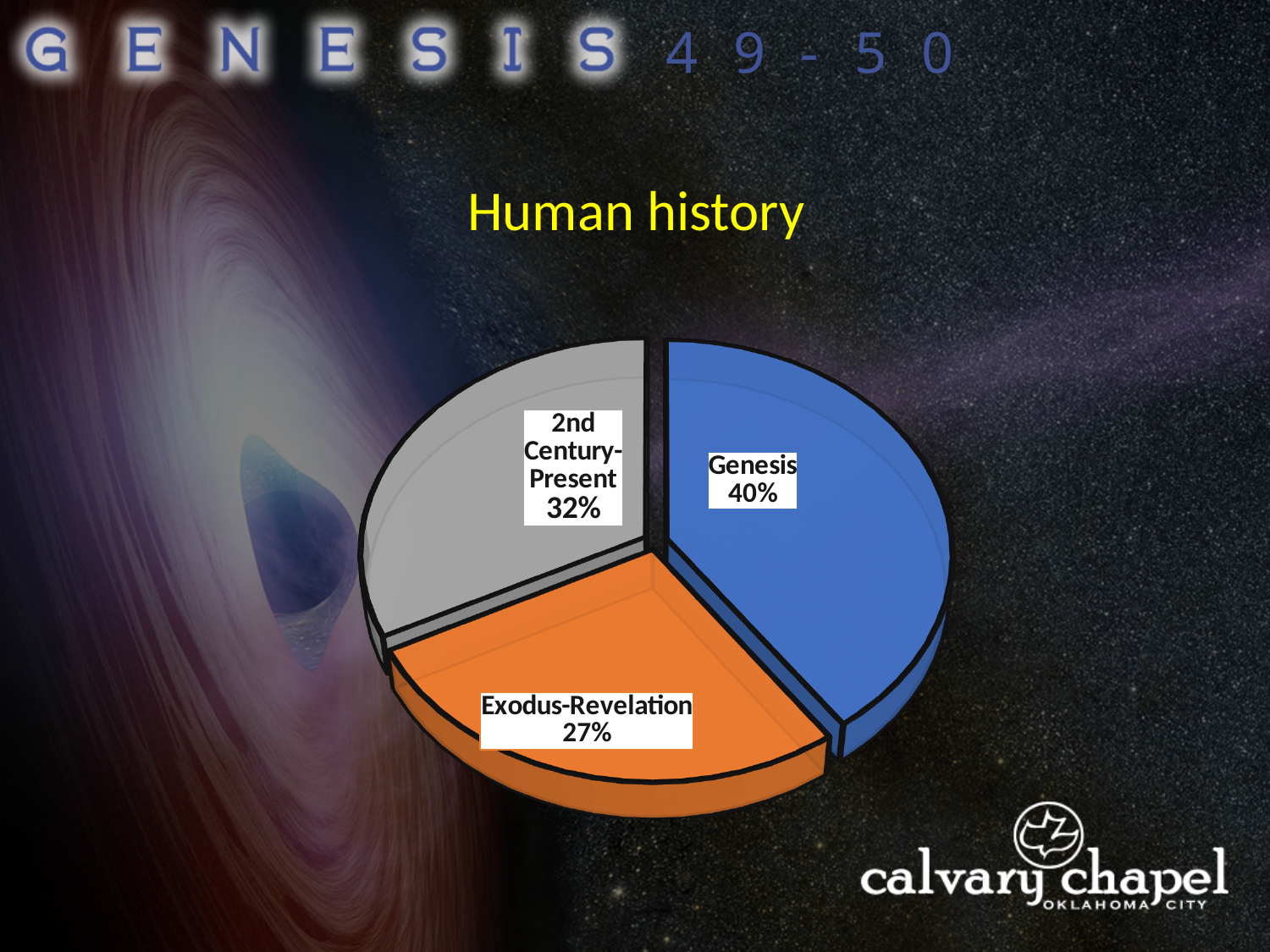
Which is larger, the 2nd Century-Present slice or the Exodus-Revelation slice? 2nd Century-Present How many slices does the pie chart have? 3 What is the difference in percentage points between the Genesis slice and the 2nd Century-Present slice? 8 What is the difference in percentage points between the Genesis slice and the Exodus-Revelation slice? 13 What kind of chart is shown on the slide? pie chart What is the title of the chart? Human history What percentage does the 2nd Century-Present slice represent? 32% Which slice has the largest share? Genesis Which slice has the smallest share? Exodus-Revelation What percentage does the Exodus-Revelation slice represent? 27% What percentage does the Genesis slice represent? 40% What colour is the Genesis slice? blue